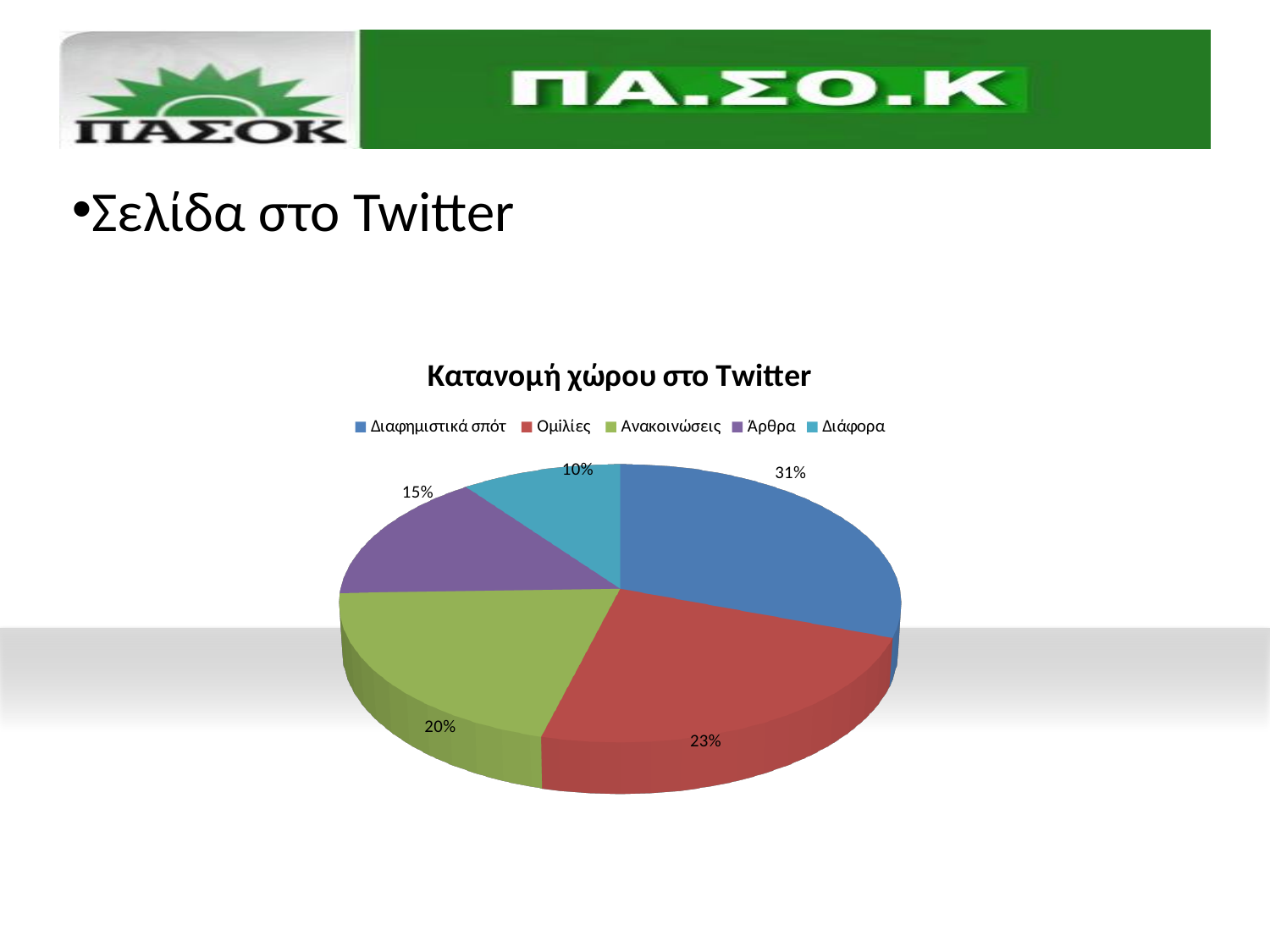
How many categories does the pie chart show? 5 What kind of chart is shown on the slide? pie chart What share of the pie does Άρθρα have? 15% What share of the pie does Διαφημιστικά σπότ have? 31% What is the difference between the shares of Διαφημιστικά σπότ and Ομιλίες? 8% What share of the pie does Διάφορα have? 10% Which category has the smallest slice of the pie? Διάφορα Which is larger, the share for Ανακοινώσεις or the share for Άρθρα? Ανακοινώσεις Which category has the largest slice of the pie? Διαφημιστικά σπότ What is the title of the chart? Κατανομή χώρου στο Twitter